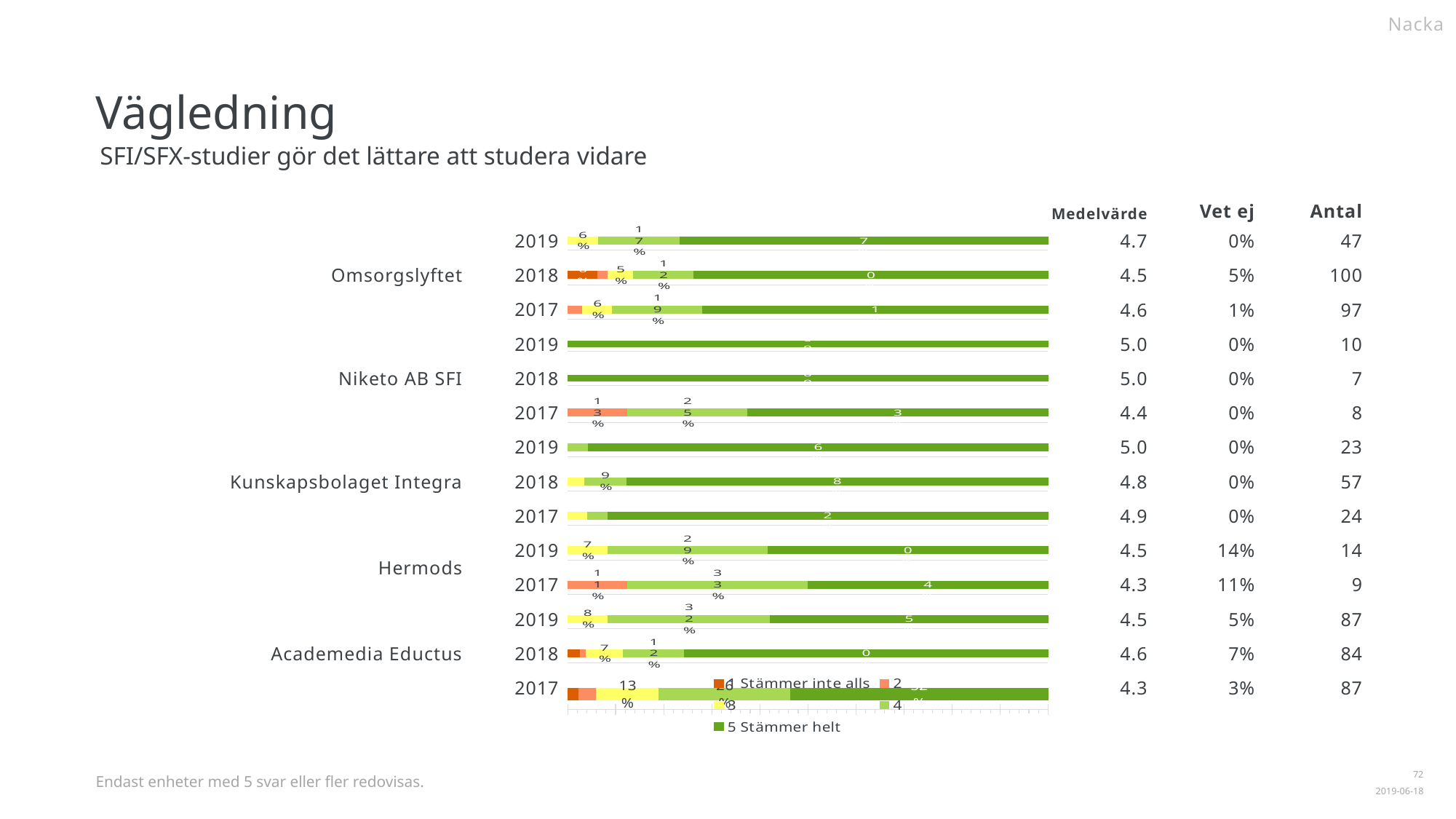
What kind of chart is shown on the slide? Stacked bar chart What is the legend label for the darkest green series? 5 Stämmer helt How many bars (year rows) are plotted in the chart? 14 How many provider groups are shown on the chart's vertical axis? 5 What is the value of the orange (2) segment for Niketo AB SFI 2017? 13% What is the legend label for the dark orange series? 1 Stämmer inte alls Which is larger: the light green (4) segment for Hermods 2017 or for Hermods 2019? Hermods 2017 Which Niketo AB SFI year has the smallest share of 5 Stämmer helt? 2017 What is the value of the yellow (3) segment for Omsorgslyftet 2019? 6% What is the value of the light green (4) segment for Hermods 2017? 33% What is the value of the yellow (3) segment for Academedia Eductus 2017? 13% How many series does the chart legend list? 5